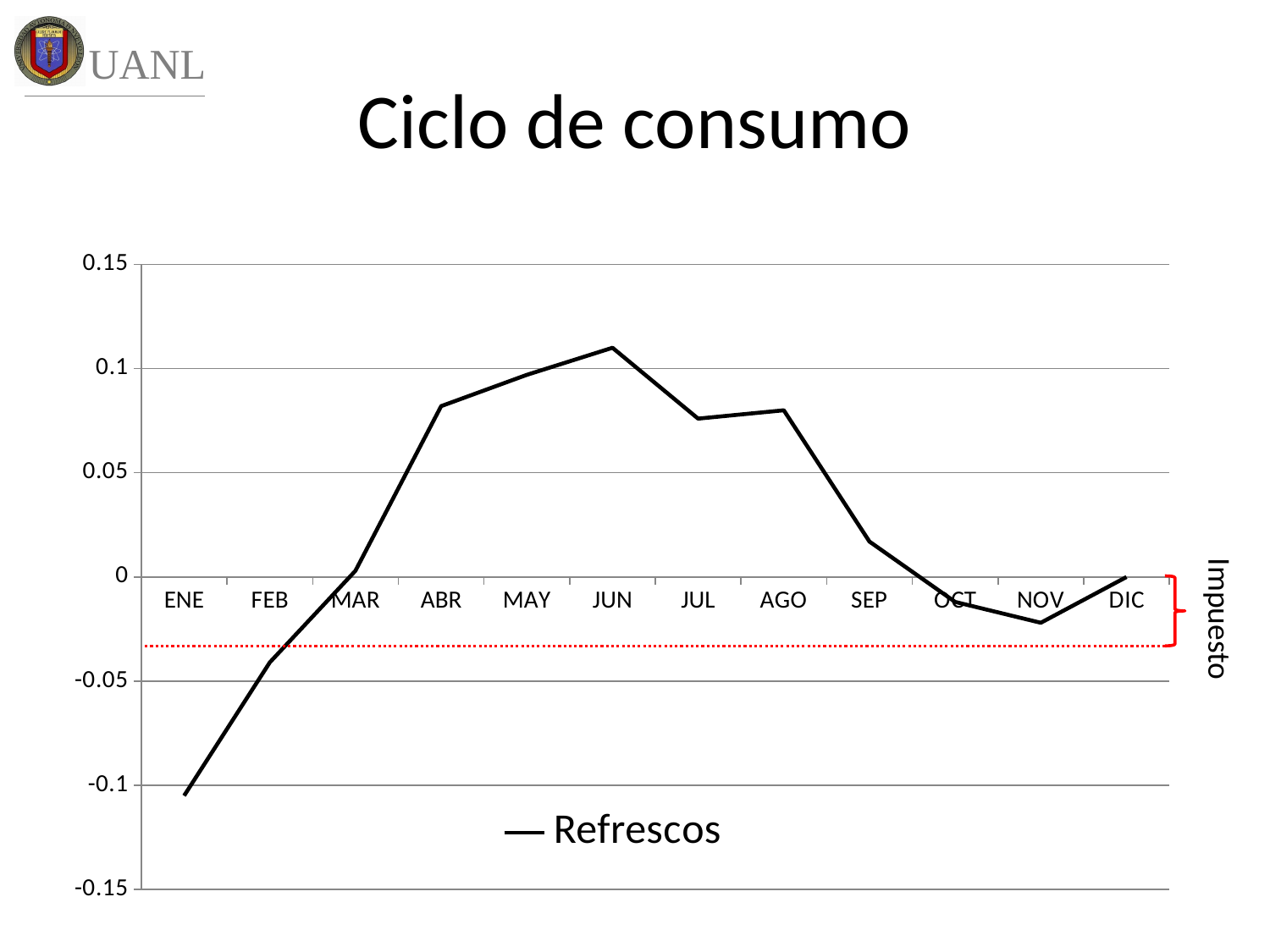
In which month does the Refrescos line reach its highest value? JUN Is the value for JUN greater or less than 0.1? greater Which month has a higher value, JUN or SEP? JUN In which month does the Refrescos line reach its lowest value? ENE Is the value for ABR greater or less than 0.05? greater How many series does the chart legend list? 1 What is the title of the chart on the slide? Ciclo de consumo Does the Refrescos line rise or fall from ENE to JUN? rise How many months are plotted along the x axis? 12 What kind of chart is shown on the slide? line chart What is the name of the series shown in the legend? Refrescos